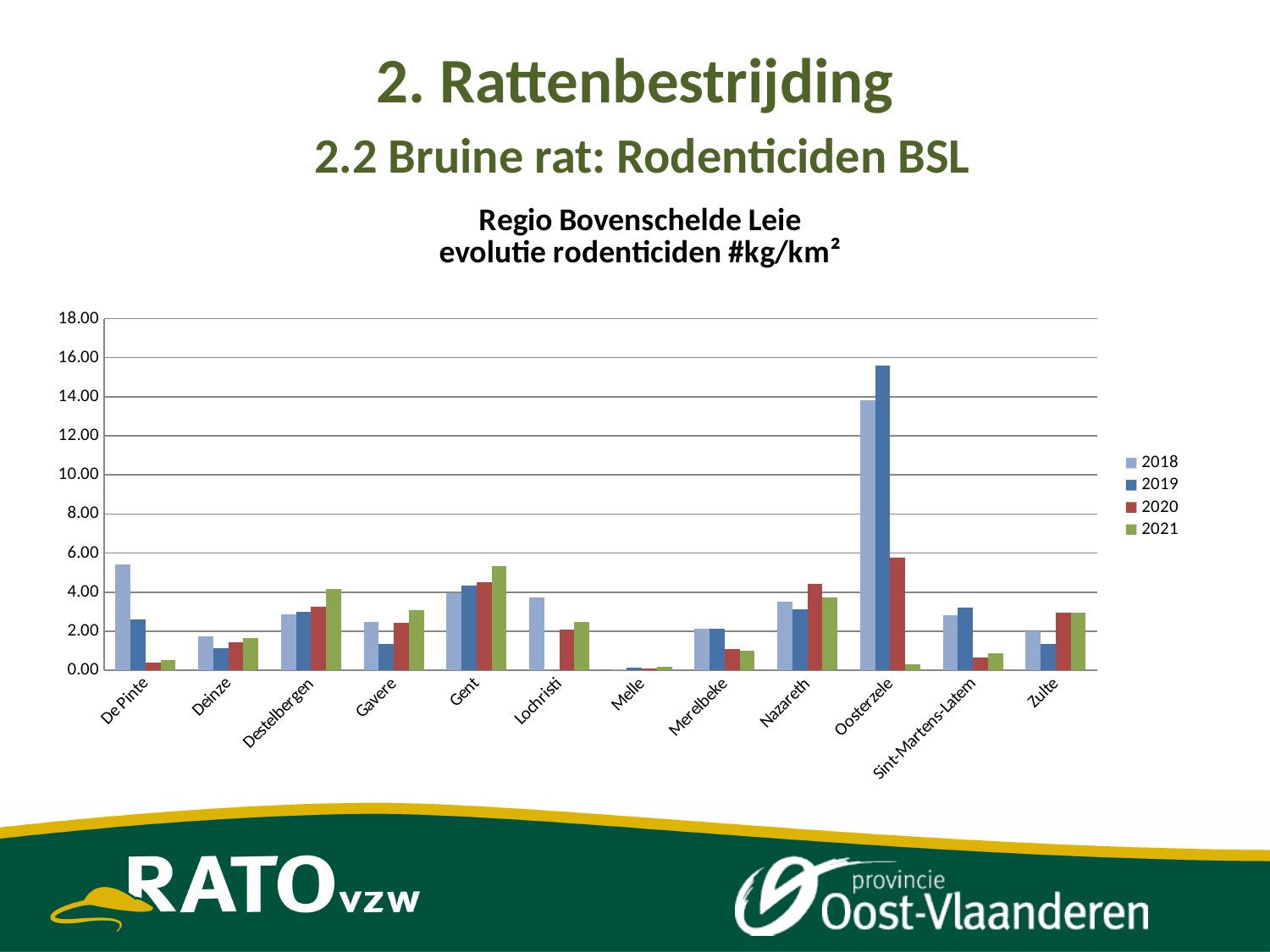
For Oosterzele, which is larger: the 2018 value or the 2019 value? 2019 Is the 2018 value for Oosterzele greater or less than 12.00? greater Which municipality has the highest bar in the chart? Oosterzele How many series does the chart's legend list? 4 Which municipality has the highest 2021 value in the chart? Gent Is the 2018 value for De Pinte greater or less than 4.00? greater For De Pinte, which is larger: the 2018 value or the 2019 value? 2018 Is the 2021 value for Oosterzele greater or less than 2.00? less Which municipality has the lowest values across all years in the chart? Melle How many municipalities (categories) are shown on the x axis of the chart? 12 What kind of chart is shown on the slide? bar chart